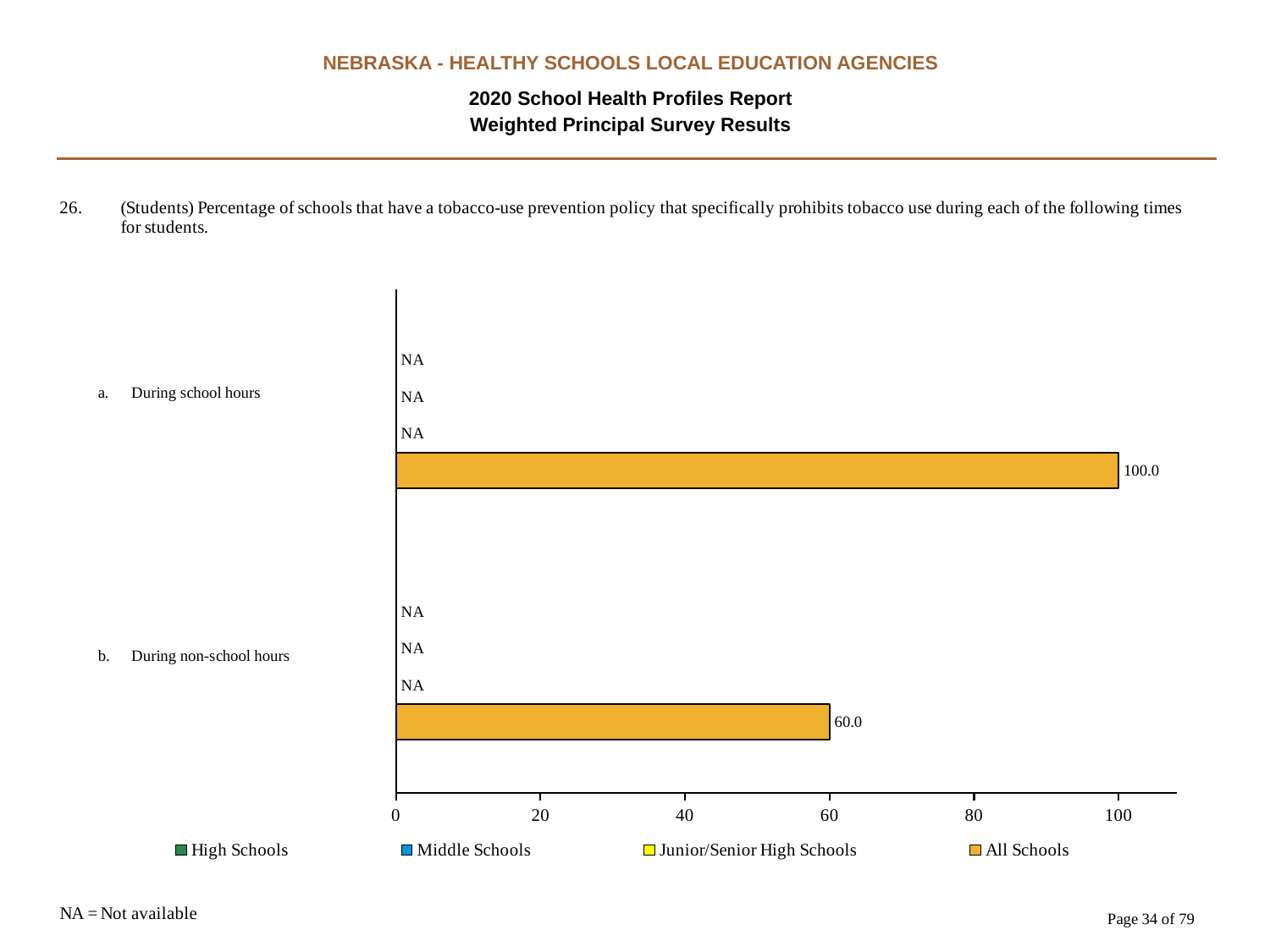
Is the All Schools value for 'During non-school hours' greater or less than 80? less Which category has the higher All Schools value, 'During school hours' or 'During non-school hours'? During school hours What is the difference between the All Schools values for 'During school hours' and 'During non-school hours'? 40.0 What kind of chart is shown on the slide? bar chart What value is shown for High Schools for 'During school hours'? NA How many series does the legend list? 4 What value is shown for Middle Schools for 'During non-school hours'? NA What is the value for All Schools for 'During school hours'? 100.0 What is the value for All Schools for 'During non-school hours'? 60.0 How many categories are shown on the chart? 2 What does NA stand for according to the note on the slide? Not available Which category has the lowest All Schools value? During non-school hours